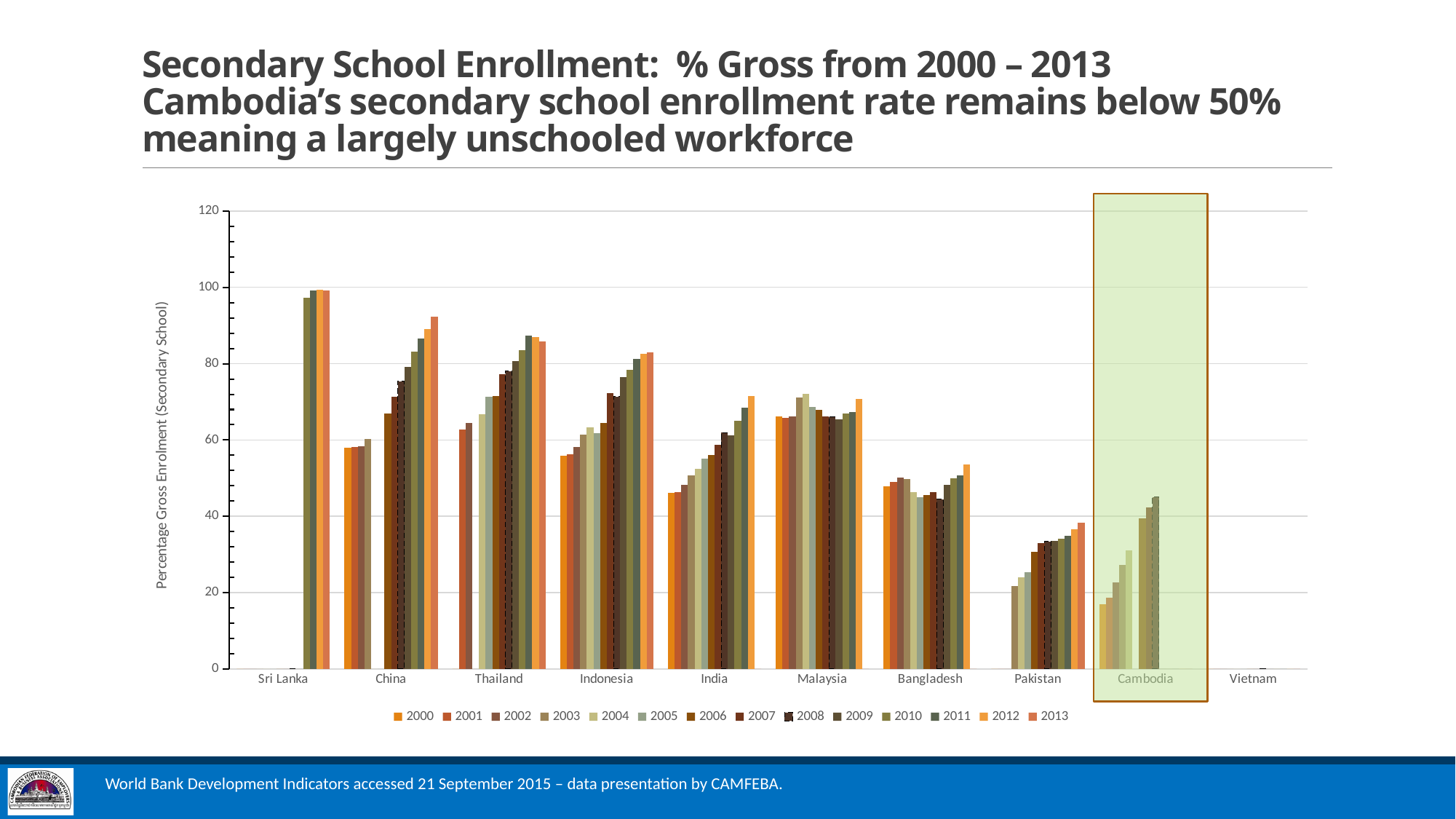
Is the 2012 value for Sri Lanka greater or less than 80? greater Which country is highlighted with a shaded box on the chart? Cambodia Which is larger, the 2013 value for China or the 2013 value for Thailand? China Among the countries with bars plotted, which has the lowest secondary school enrollment values? Cambodia Is the 2000 value for India greater or less than 60? less Is the 2013 value for China greater or less than 80? greater Which country has the highest secondary school enrollment bars in the chart? Sri Lanka How many countries are listed along the x axis of the chart? 10 What kind of chart is shown on the slide? bar chart How many series (years) does the chart legend list? 14